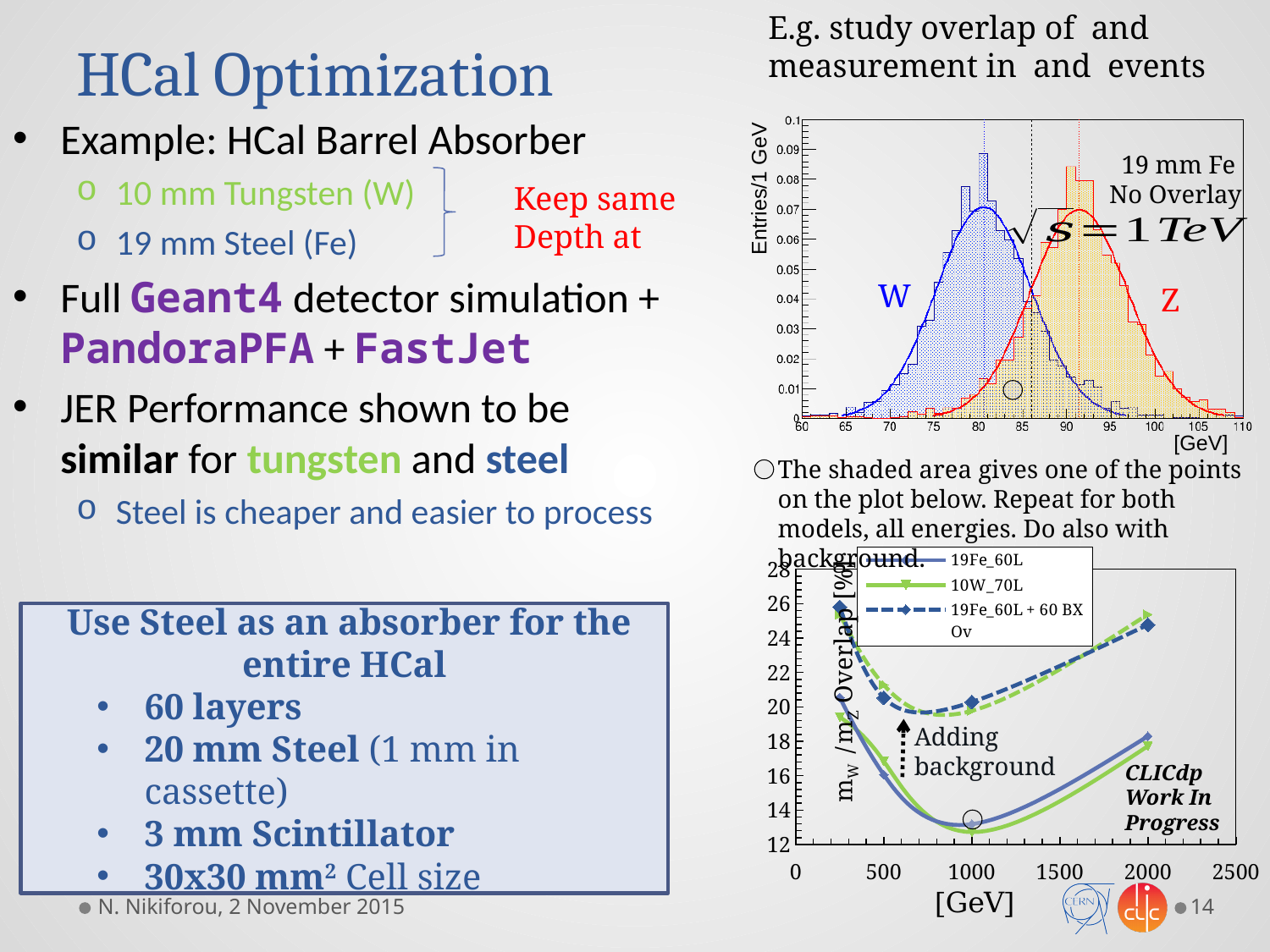
On the bottom-right chart, at 2000 GeV, is the value for 19Fe_60L greater or less than 20? less On the bottom-right chart, what is the label of the dashed series in the legend? 19Fe_60L + 60 BX Ov On the bottom-right chart, what kind of chart is it? line chart On the top-right chart, is the peak of the W distribution located at a mass greater or less than 85 GeV? less On the top-right chart, which distribution peaks at a higher mass, W or Z? Z On the bottom-right chart, at 1000 GeV, which series has the larger value: 19Fe_60L or 19Fe_60L + 60 BX Ov? 19Fe_60L + 60 BX Ov On the bottom-right chart, what is the y-axis label? mW / mZ Overlap [%] On the bottom-right chart, how many series does the legend list? 3 On the top-right chart, what is the y-axis label? Entries/1 GeV On the bottom-right chart, at 1000 GeV, is the value for 19Fe_60L greater or less than 16? less On the bottom-right chart, how do the values of the 19Fe_60L series change as the x axis goes from 250 to 2000 GeV? They fall to a minimum near 1000 GeV and then rise